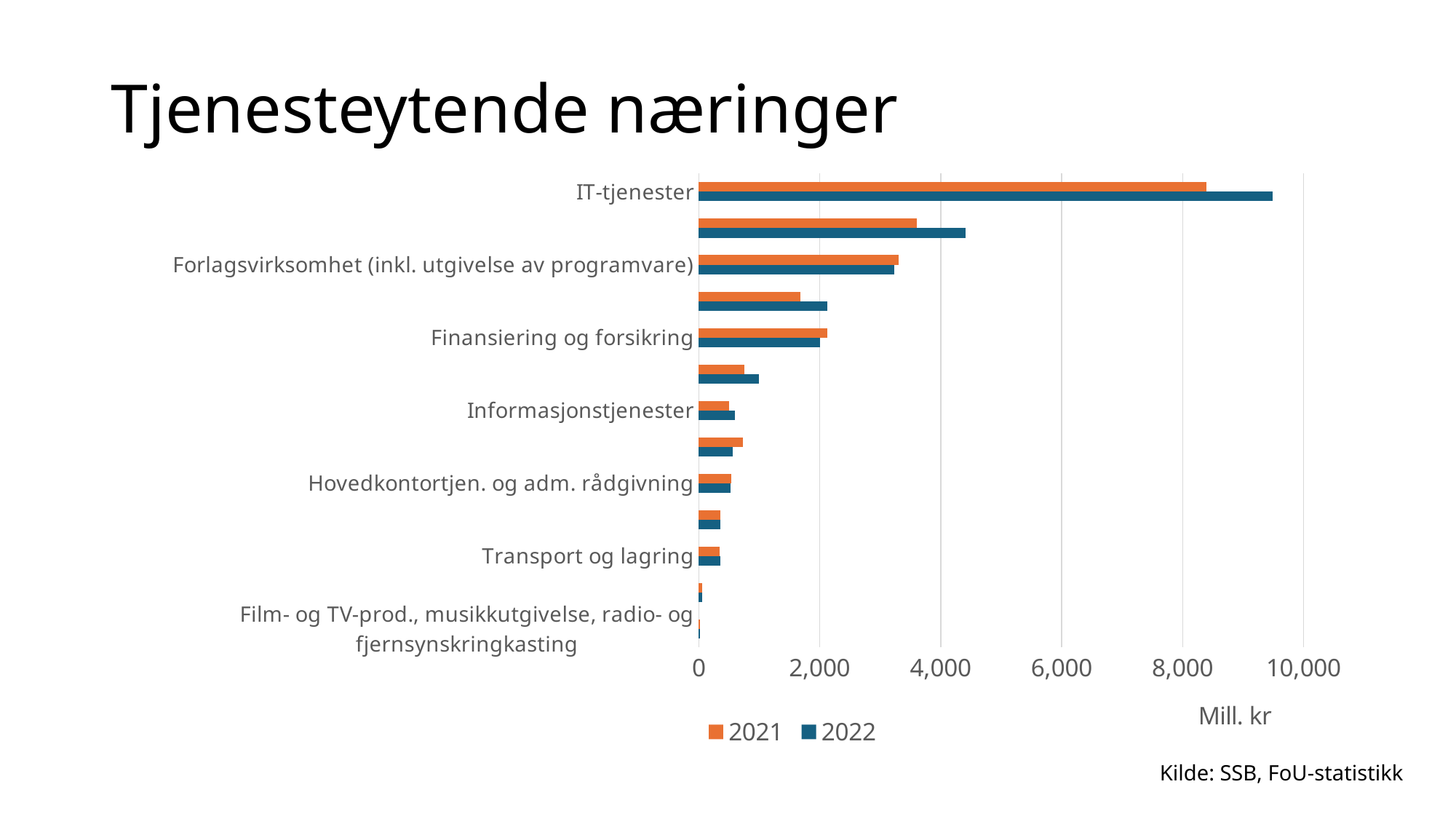
What unit is shown on the value axis of the chart? Mill. kr Which labelled category has the lowest value for 2022? Film- og TV-prod., musikkutgivelse, radio- og fjernsynskringkasting Is the 2022 value for IT-tjenester greater or less than 8,000? greater For 2022, which is larger: Forlagsvirksomhet (inkl. utgivelse av programvare) or Finansiering og forsikring? Forlagsvirksomhet (inkl. utgivelse av programvare) Which category has the highest value for 2021? IT-tjenester What kind of chart is shown on the slide? Bar chart How many series does the legend list? 2 Is the 2022 value for Transport og lagring greater or less than 2,000? less Is the 2022 value for Informasjonstjenester greater or less than 2,000? less For IT-tjenester, which year has the larger value, 2021 or 2022? 2022 Which category has the highest value for 2022? IT-tjenester